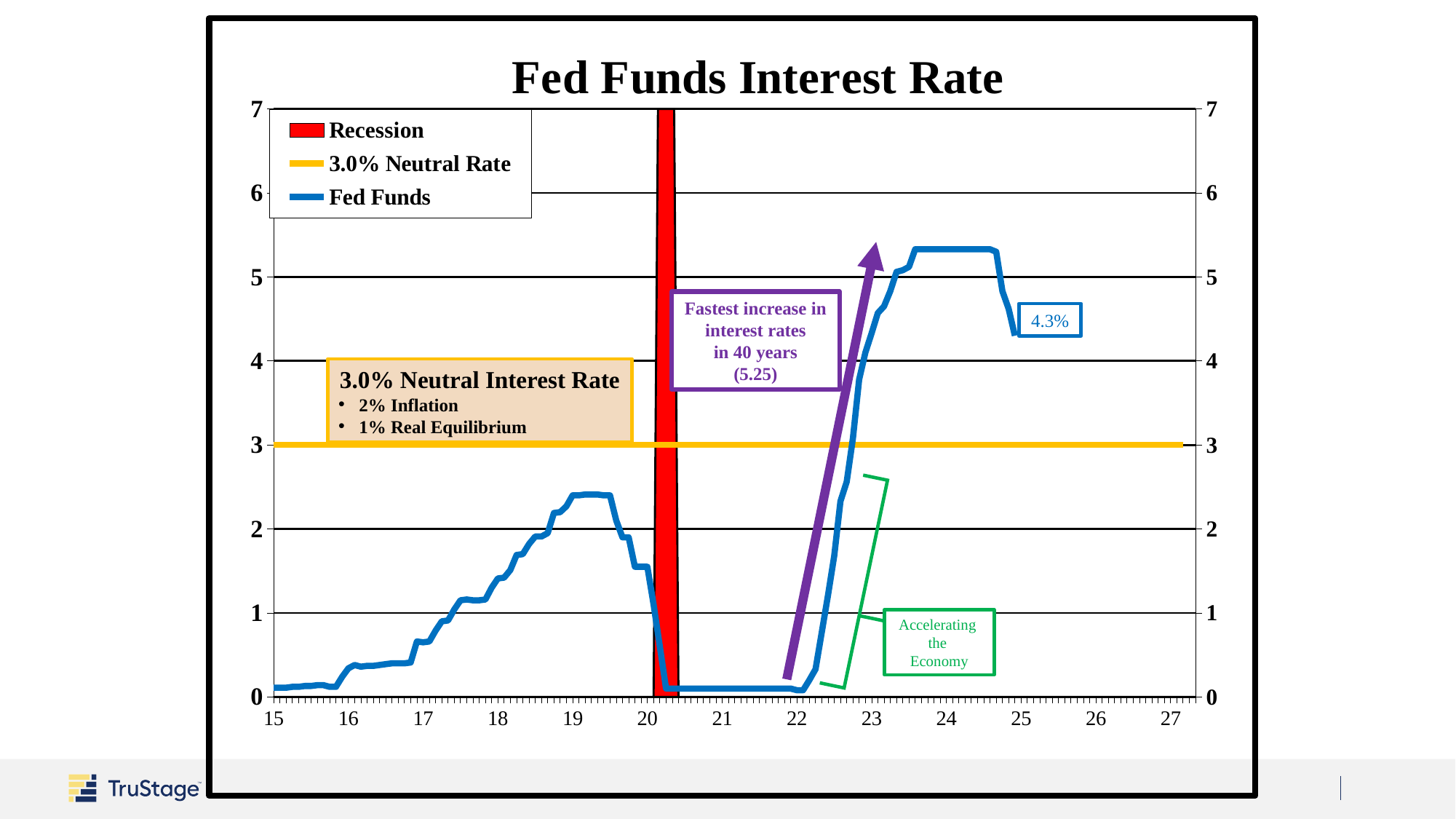
What kind of chart is shown on the slide? line chart Is the Fed Funds value at 24 greater or less than 5? greater Is the Fed Funds value at 21 greater or less than 1? less At what level is the neutral rate line drawn, according to the legend? 3.0% Does the Fed Funds line rise or fall between 22 and 23? rise What is the title of the chart? Fed Funds Interest Rate Which is larger, the Fed Funds value at 24 or at 19? 24 Is the Fed Funds value at 19 greater or less than 3? less What does the red shaded bar on the chart represent, according to the legend? Recession What value is printed as the data label at the end of the Fed Funds line? 4.3% How many entries does the chart legend list? 3 Around which year on the x axis does the Fed Funds line reach its highest level? 24